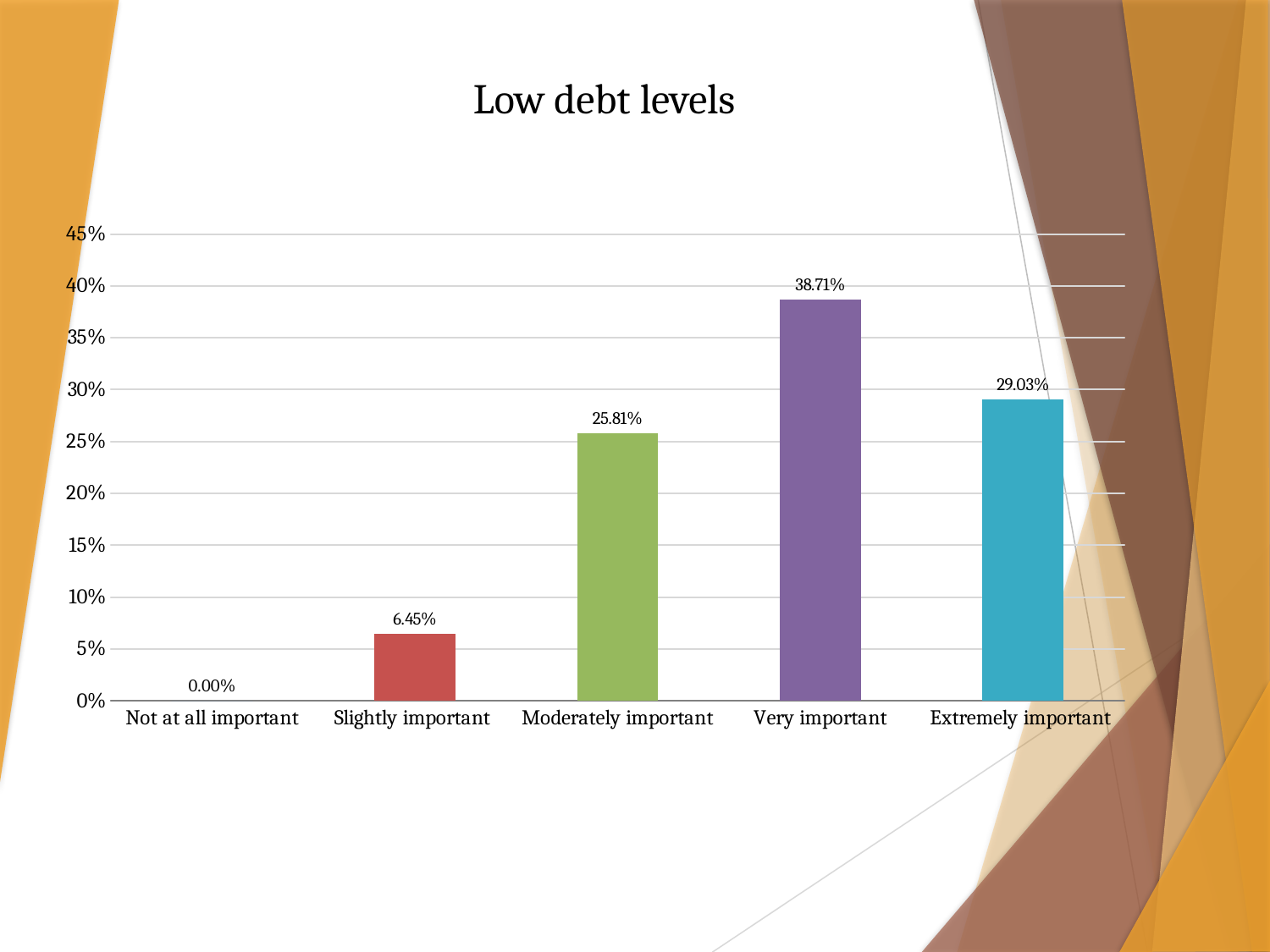
Which category has the lowest value? Not at all important What is the value for Slightly important? 6.45% What is the value for Very important? 38.71% What is the difference between the values for Very important and Extremely important? 9.68% What is the value for Moderately important? 25.81% Which category has the highest value? Very important Which is larger, the value for Moderately important or the value for Extremely important? Extremely important How many categories are shown on the x axis? 5 What kind of chart is shown on the slide? bar chart Is the value for Moderately important greater or less than 30%? less What is the title of the chart? Low debt levels What is the value for Extremely important? 29.03%